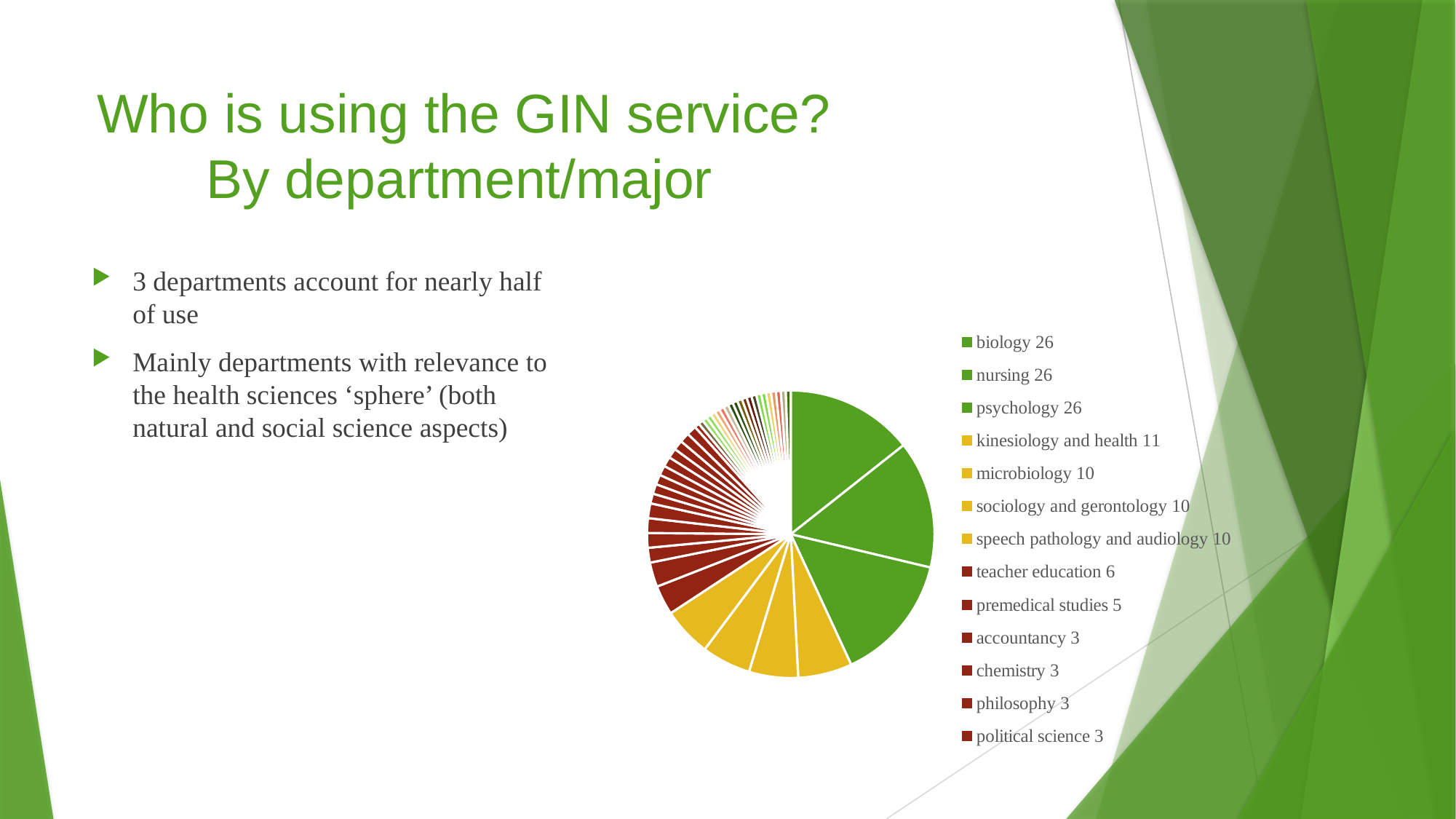
What value is shown for teacher education? 6 What is the largest value listed in the chart legend? 26 How many entries are listed in the chart legend? 13 What value is shown for speech pathology and audiology? 10 What is the difference between the values for nursing and microbiology? 16 Which has a larger value, premedical studies or chemistry? premedical studies What value is shown for biology in the chart legend? 26 What is the difference between the values for kinesiology and health and teacher education? 5 What type of chart is shown on the slide? pie chart Which has a larger value, psychology or sociology and gerontology? psychology What value is shown for kinesiology and health? 11 What value is shown for premedical studies? 5